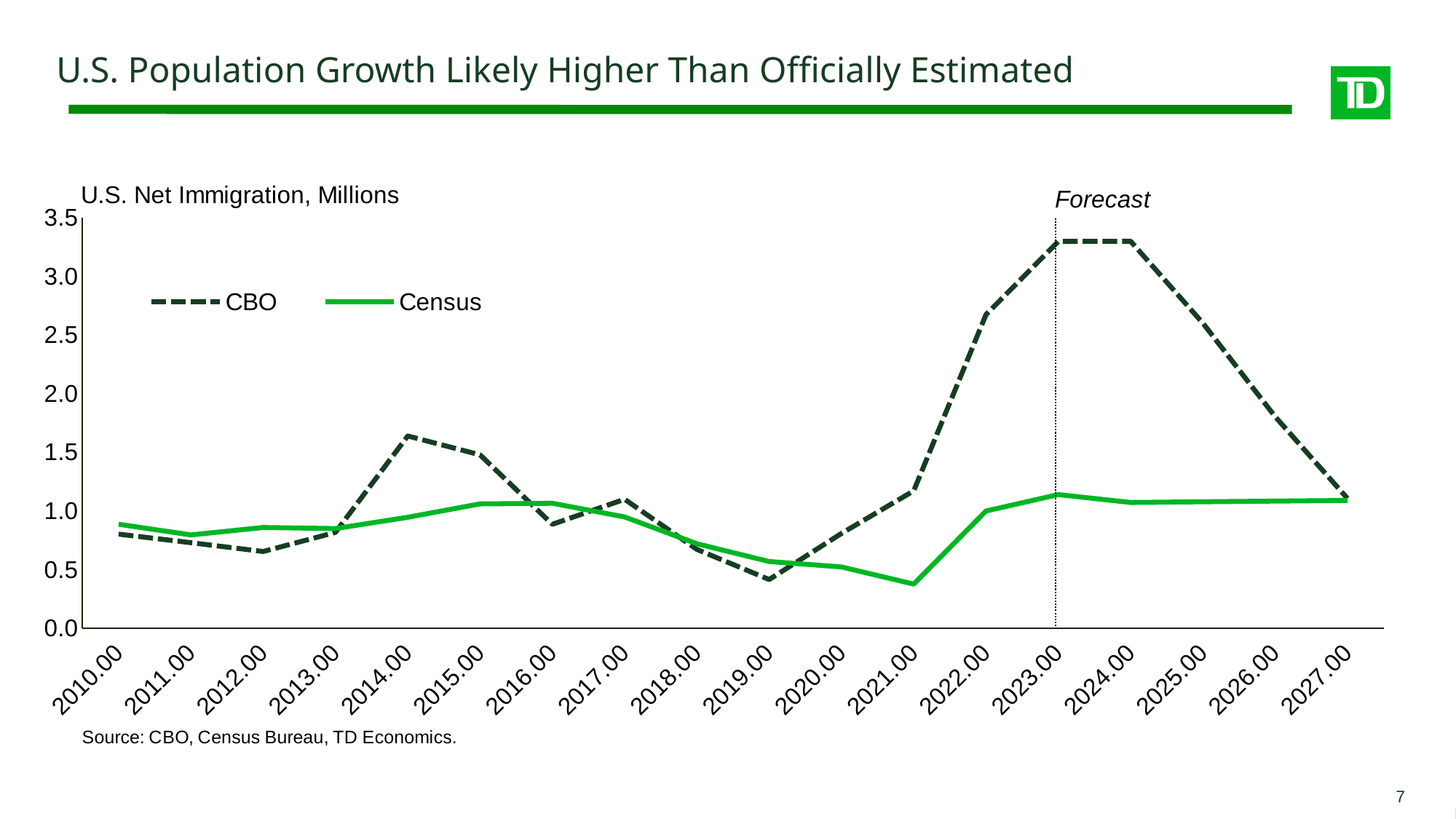
Is the CBO value for 2023.00 greater or less than 3.0? greater What type of chart is shown on the slide? Line chart Is the CBO value for 2014.00 greater or less than 1.5? greater What does the dotted vertical line at 2023.00 mark? Forecast In 2023.00, which series has the higher value, CBO or Census? CBO Is the Census value for 2021.00 greater or less than 0.5? less In which year is the Census series at its lowest? 2021.00 What is the title of the chart? U.S. Net Immigration, Millions How many years are shown along the x axis? 18 How many series does the legend list? 2 Does the CBO series rise or fall from 2024.00 to 2027.00? Fall